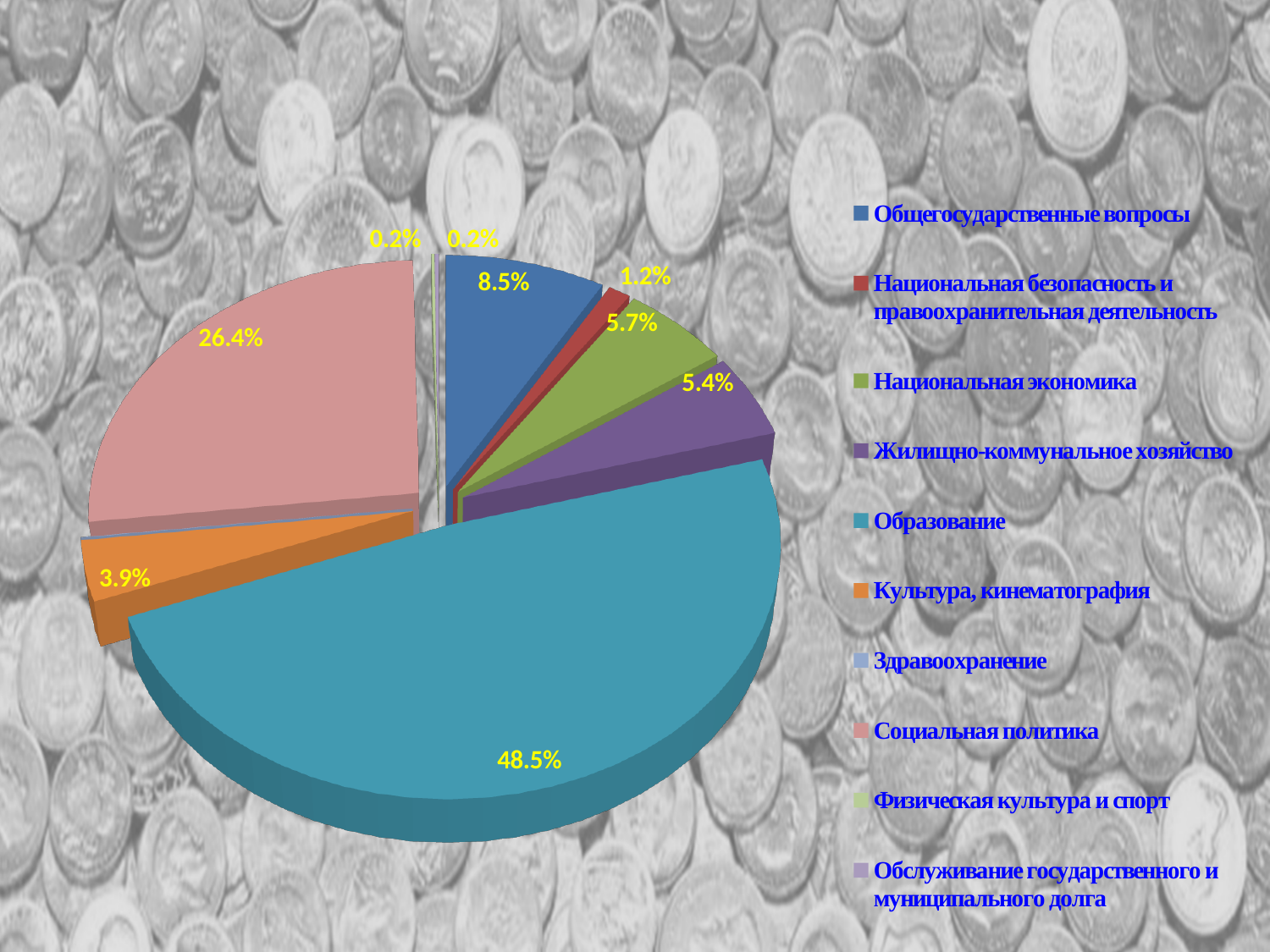
What value is shown for Социальная политика? 26.4% What value is shown for Национальная экономика? 5.7% What share of the pie does Образование have? 48.5% What is the difference between the shares of Образование and Социальная политика? 22.1% What type of chart is shown on the slide? pie chart What value is shown for Национальная безопасность и правоохранительная деятельность? 1.2% Which is larger, the share for Национальная экономика or for Жилищно-коммунальное хозяйство? Национальная экономика How many categories does the legend of the pie chart list? 10 Which category has the largest slice of the pie? Образование What value is shown for Общегосударственные вопросы? 8.5% What value is shown for Культура, кинематография? 3.9% What value is shown for Жилищно-коммунальное хозяйство? 5.4%